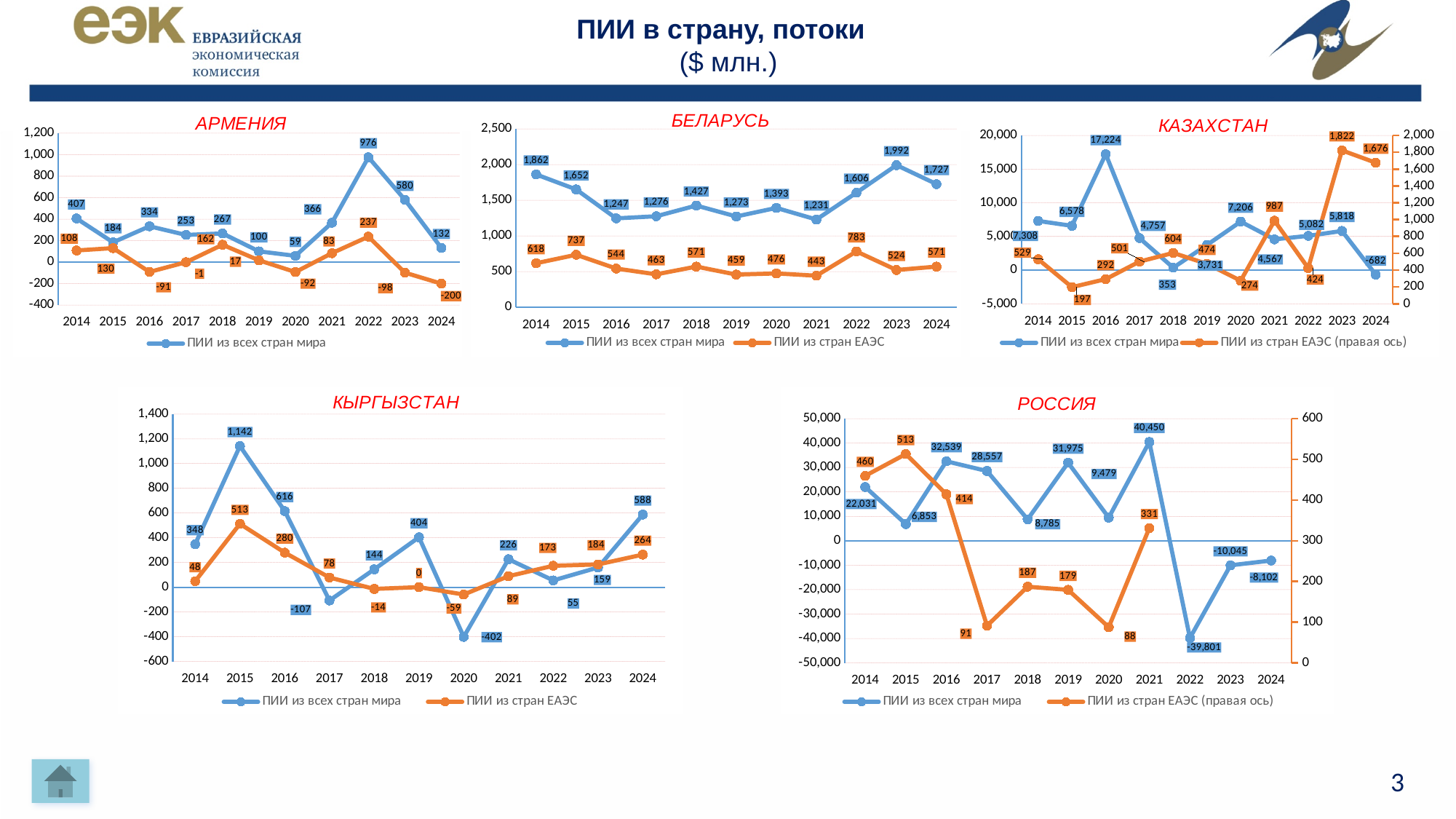
On the БЕЛАРУСЬ chart, does ПИИ из всех стран мира rise or fall from 2021 to 2023? Rise On the КЫРГЫЗСТАН chart, which year has the larger ПИИ из всех стран мира value, 2015 or 2024? 2015 How many series does the legend of the БЕЛАРУСЬ chart list? 2 On the БЕЛАРУСЬ chart, in which year is ПИИ из всех стран мира highest? 2023 On the АРМЕНИЯ chart, what is the value of ПИИ из всех стран мира for 2022? 976 What kind of chart is the КАЗАХСТАН chart? Line chart On the БЕЛАРУСЬ chart, what is the difference between the ПИИ из всех стран мира values for 2023 and 2022? 386 On the РОССИЯ chart, what is the value of ПИИ из всех стран мира for 2021? 40,450 On the КЫРГЫЗСТАН chart, in which year is ПИИ из всех стран мира lowest? 2020 On the РОССИЯ chart, what is the value of ПИИ из всех стран мира for 2022? -39,801 On the КАЗАХСТАН chart, what is the value of ПИИ из всех стран мира for 2016? 17,224 How many years are shown on the x axis of the РОССИЯ chart? 11